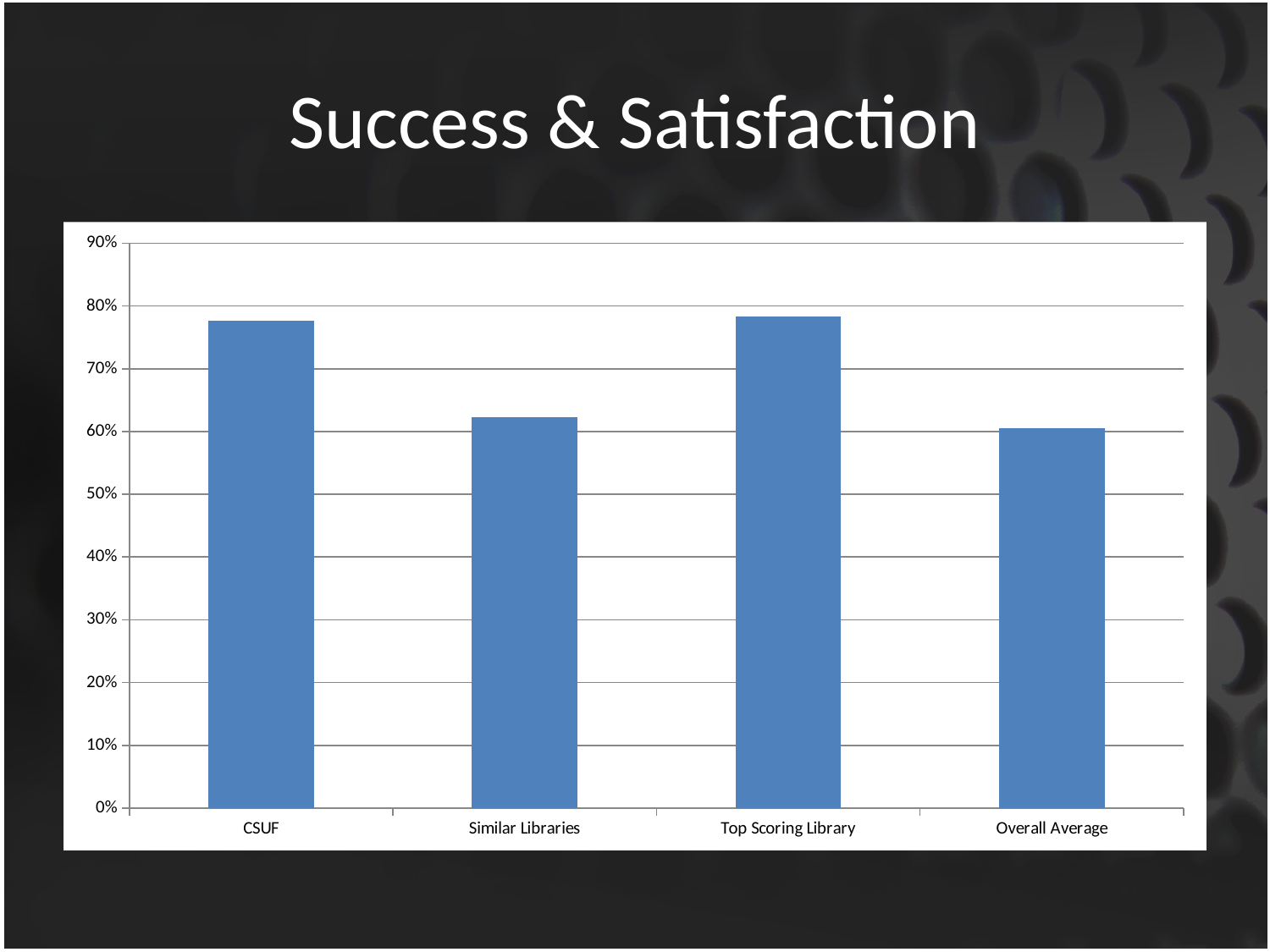
Is the value for CSUF greater or less than 80%? less What is the title of the slide containing the chart? Success & Satisfaction Which is larger, the value for Top Scoring Library or the value for Overall Average? Top Scoring Library Is the value for Similar Libraries greater or less than 70%? less What kind of chart is shown on the slide? bar chart How many categories are shown on the x axis of the chart? 4 Is the value for Top Scoring Library greater or less than 80%? less Which is larger, the value for CSUF or the value for Similar Libraries? CSUF What is the highest value shown on the chart's y axis? 90%